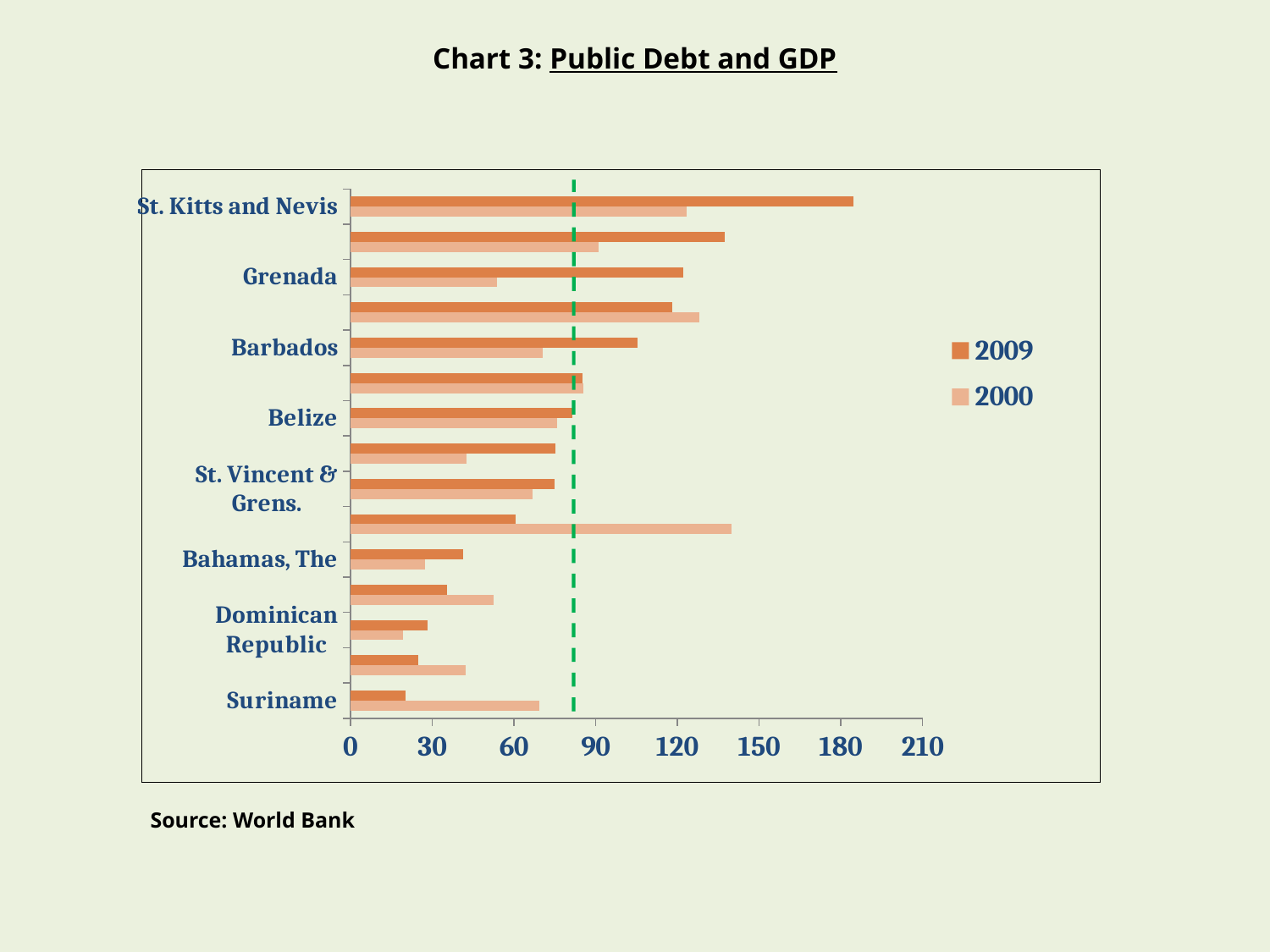
Is the 2000 value for St. Kitts and Nevis greater or less than 90? greater Is the 2009 value for St. Kitts and Nevis greater or less than 150? greater Is the 2009 value for Suriname greater or less than 30? less Which country has a larger 2009 value, St. Kitts and Nevis or Suriname? St. Kitts and Nevis What are the two series named in the legend? 2009 and 2000 How many series does the legend list? 2 Which country has the highest value for 2009? St. Kitts and Nevis What is the title of the chart? Chart 3: Public Debt and GDP For St. Kitts and Nevis, which is larger, the 2009 value or the 2000 value? 2009 For Suriname, which is larger, the 2009 value or the 2000 value? 2000 What kind of chart is shown on the slide? bar chart